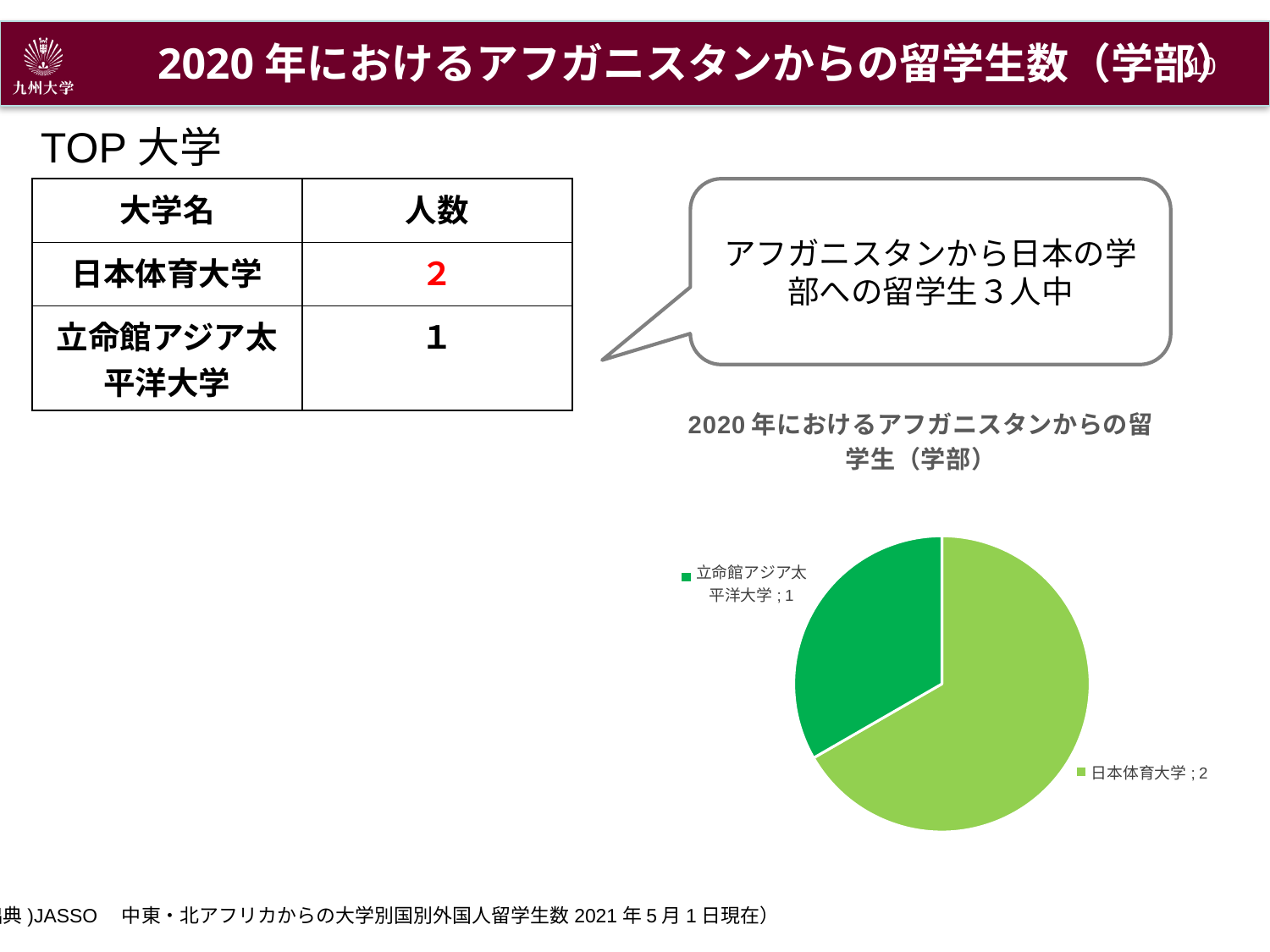
Which is larger in the pie chart, the value for 日本体育大学 or for 立命館アジア太平洋大学? 日本体育大学 Which university has the largest slice in the pie chart? 日本体育大学 Which university has the smallest slice in the pie chart? 立命館アジア太平洋大学 What colour is the slice for 立命館アジア太平洋大学 in the pie chart? dark green What is the title of the pie chart? 2020年におけるアフガニスタンからの留学生（学部） What kind of chart is shown on the slide? pie chart What share of the pie chart does 日本体育大学 account for? 2 out of 3 What is the total of all slices in the pie chart? 3 What is the difference between the values for 日本体育大学 and 立命館アジア太平洋大学 in the pie chart? 1 How many slices does the pie chart have? 2 What is the value for 日本体育大学 in the pie chart? 2 What is the value for 立命館アジア太平洋大学 in the pie chart? 1